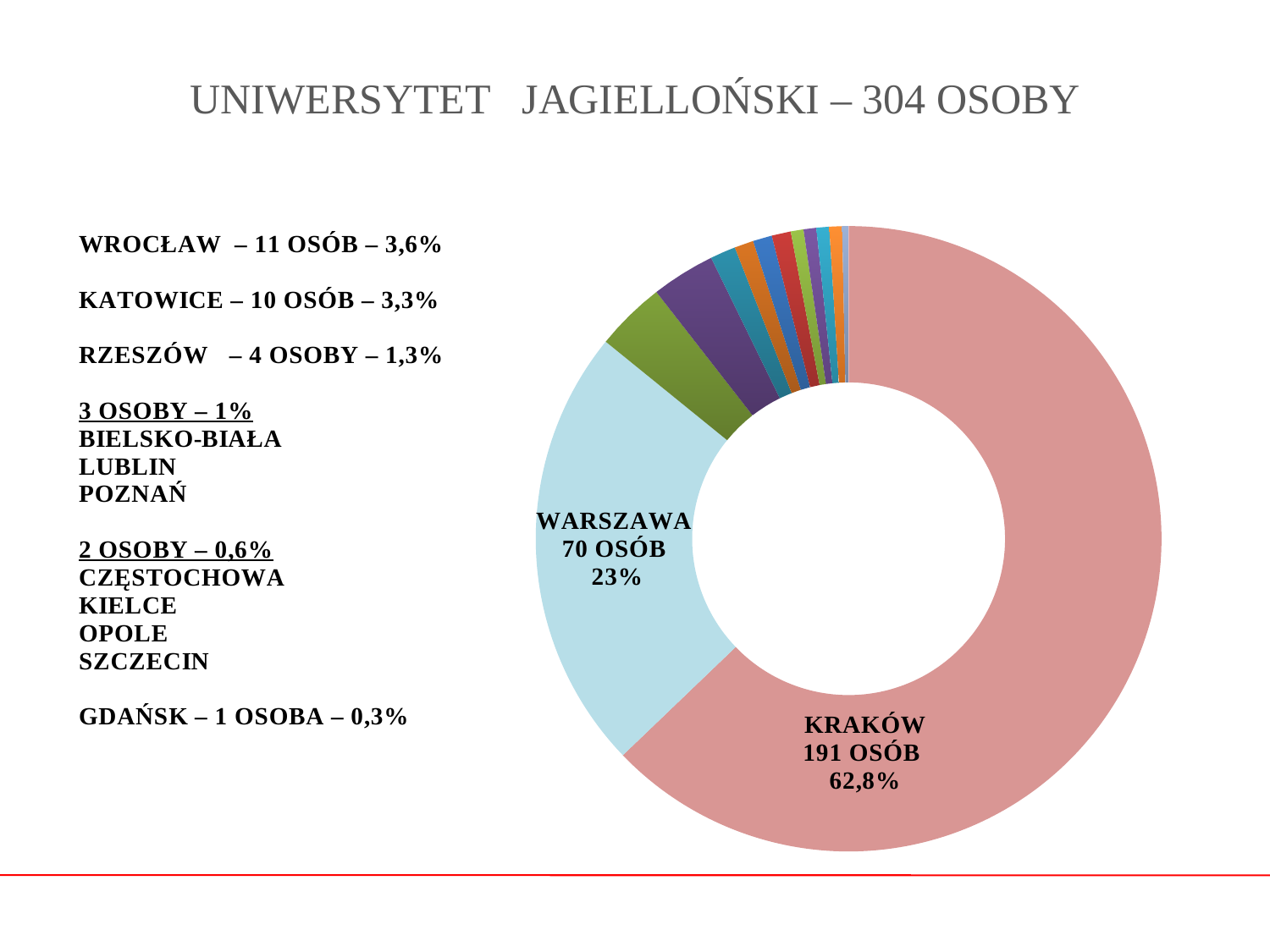
Which slice is larger, Kraków or Warszawa? Kraków According to the slide, how many people are from Wrocław? 11 osób What kind of chart is shown on the slide? Doughnut (pie) chart What is the difference in number of people between Kraków and Warszawa? 121 What is the combined number of people from Kraków and Warszawa? 261 How many people does the Kraków slice represent? 191 osób Which city has the largest slice in the chart? Kraków According to the slide, what percentage share does Gdańsk have? 0,3% What percentage share does the Warszawa slice have? 23% What percentage share does the Kraków slice have? 62,8% How many people does the Warszawa slice represent? 70 osób What is the total number of people given in the chart title? 304 osoby